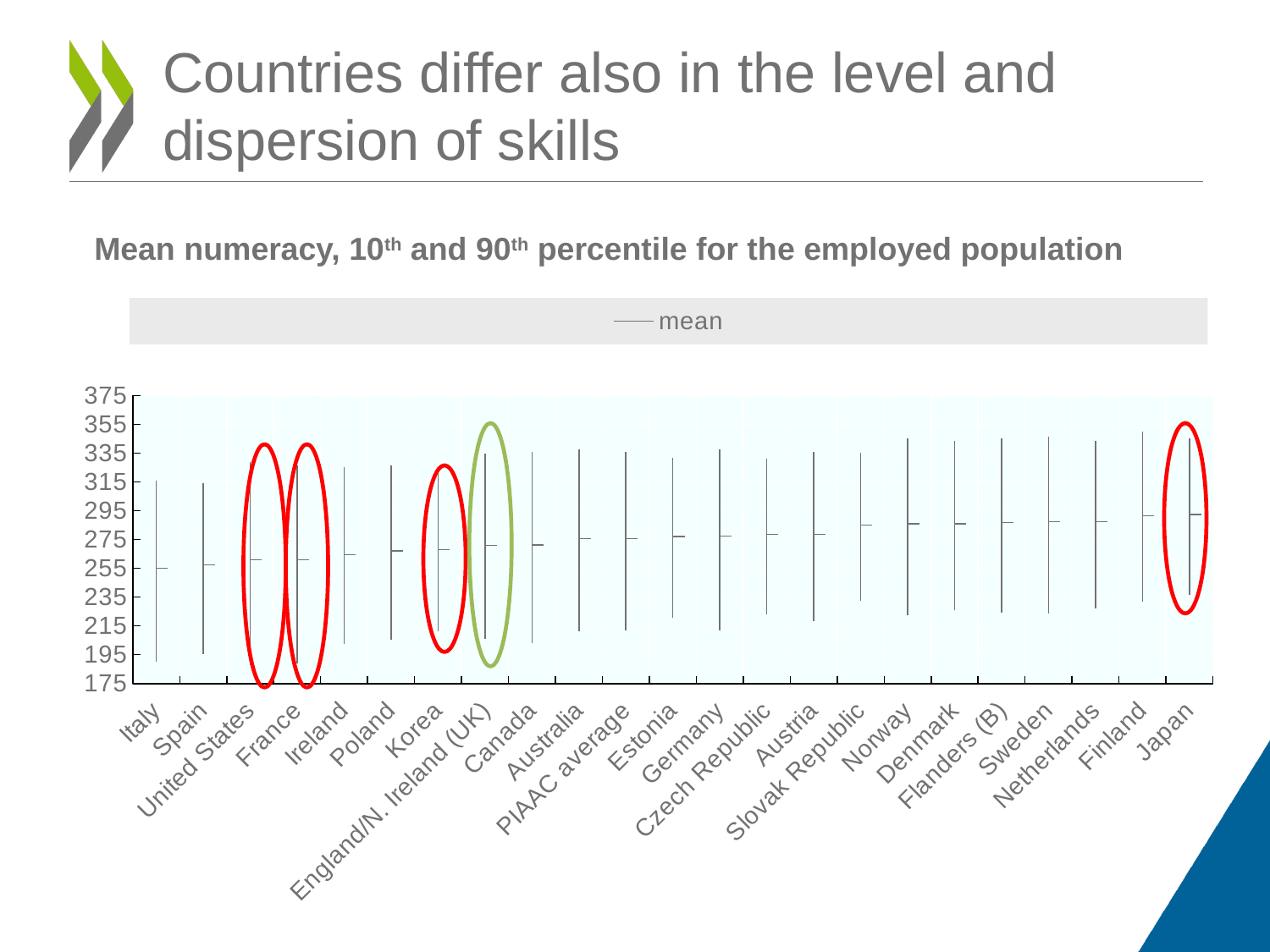
Which has the larger mean numeracy score, Italy or Japan? Japan What is the title printed above the chart? Mean numeracy, 10th and 90th percentile for the employed population How many series does the chart legend list? 1 Which has the larger mean numeracy score, Finland or Spain? Finland Is the mean numeracy value for Italy greater or less than 275? less How many countries or categories are shown along the x axis of the chart? 23 Do the mean numeracy values generally rise or fall moving from left to right along the x axis? rise Which country has the highest mean numeracy score in the chart? Japan Which category is the first (leftmost) on the x axis of the chart? Italy Is the mean numeracy value for Japan greater or less than 275? greater What is the only entry shown in the chart legend? mean Is the mean numeracy value for Norway greater or less than 255? greater